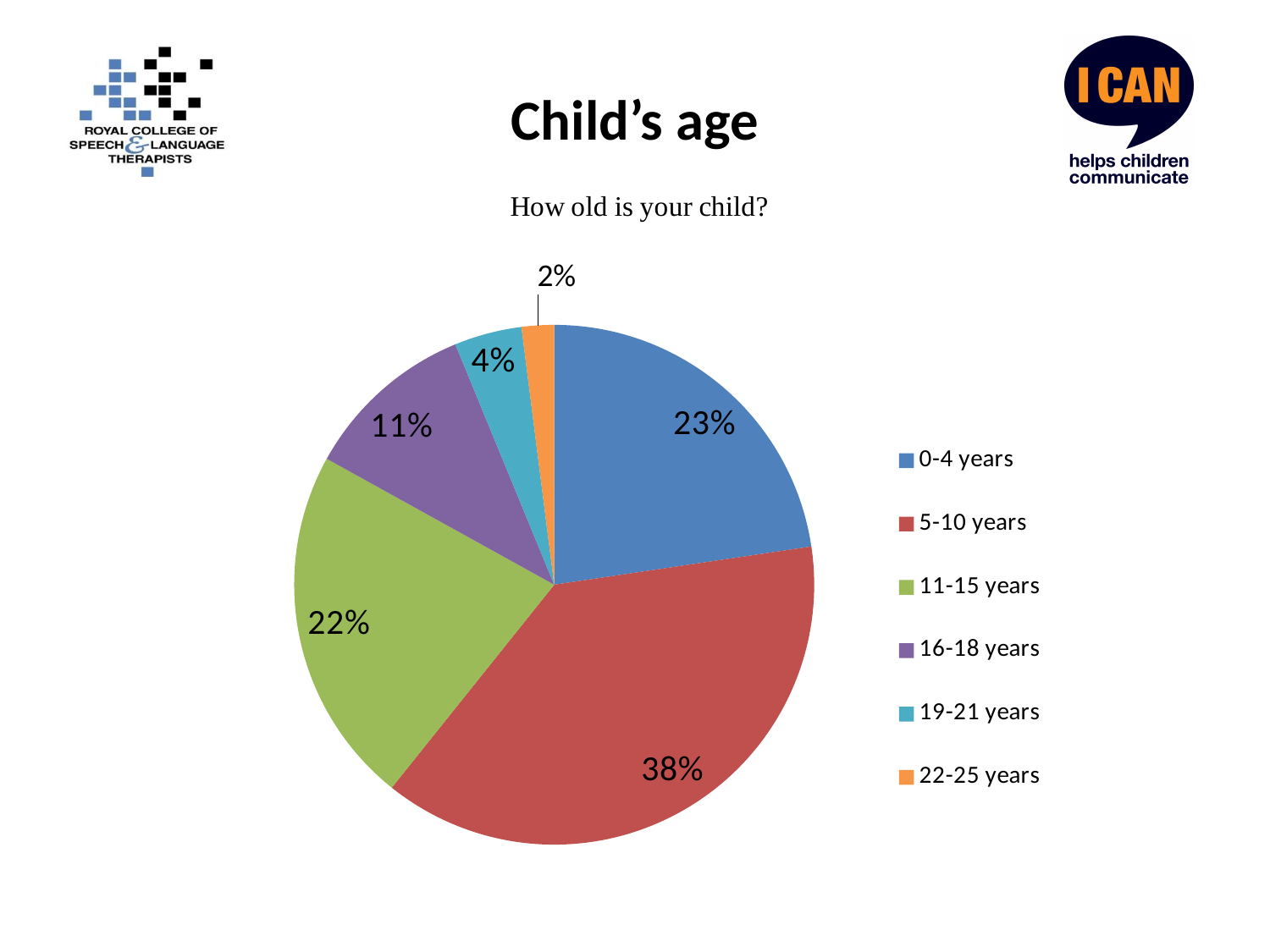
What is the title of the chart? How old is your child? What colour is the slice for 19-21 years? light blue Which age group has the smallest share of the pie? 22-25 years What percentage of children are aged 0-4 years? 23% Which is larger, the share for 0-4 years or the share for 11-15 years? 0-4 years What kind of chart is shown on the slide? pie chart How many age groups does the legend list? 6 What percentage of children are aged 16-18 years? 11% What percentage of children are aged 22-25 years? 2% Which age group has the largest share of the pie? 5-10 years What is the difference in percentage points between the 5-10 years and 11-15 years slices? 16 What percentage of children are aged 5-10 years? 38%